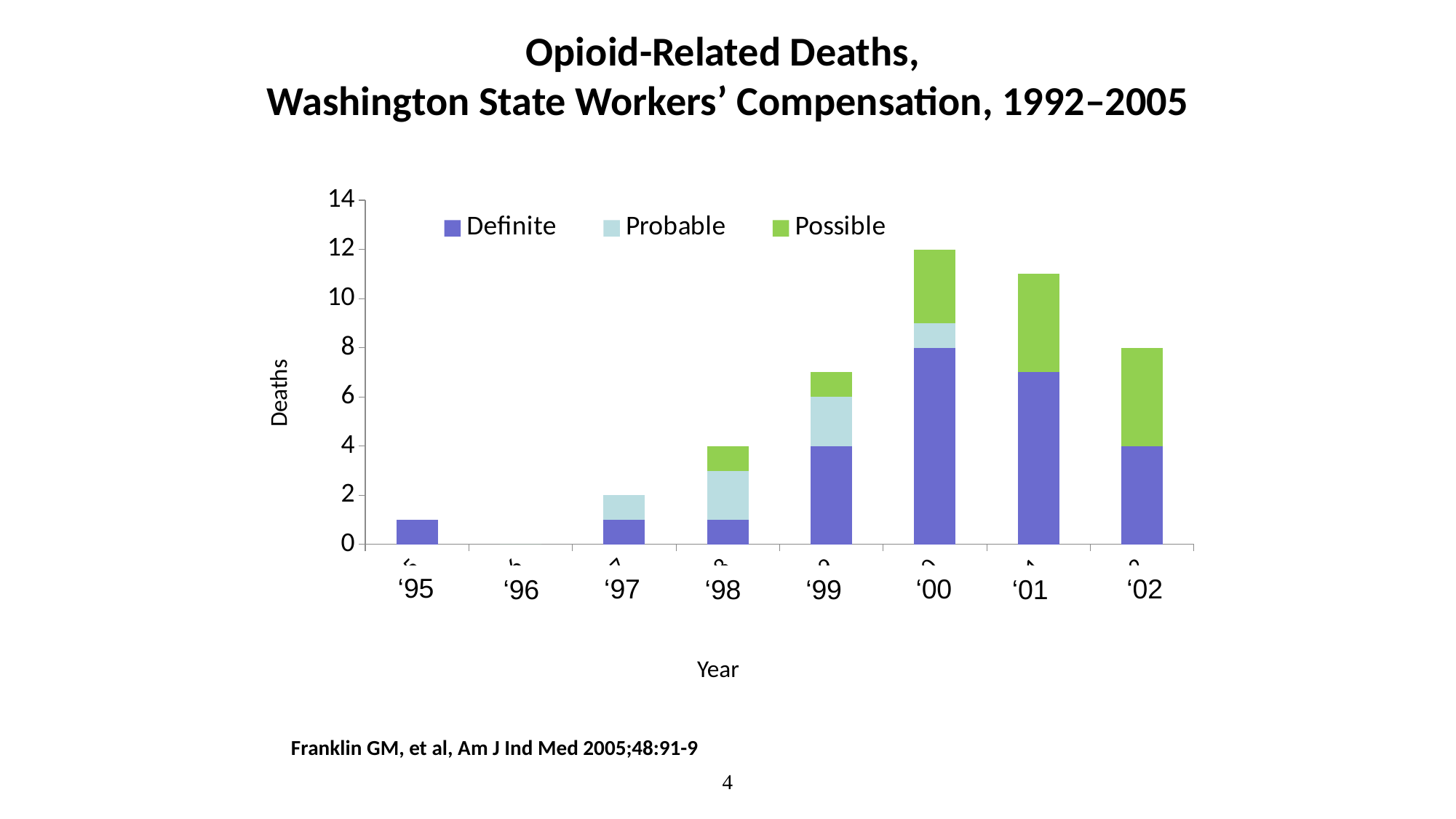
Which year shows no deaths at all? '96 What is the total number of deaths in '98? 4 What is the total number of deaths in '00? 12 Which year has the highest total number of deaths? '00 Is the total number of deaths in '01 greater or less than 10? greater What kind of chart is shown on the slide? Stacked bar chart How many years are shown on the x axis? 8 Is the total number of deaths in '99 greater or less than 6? greater What is the total number of deaths in '02? 8 Which year has more total deaths, '00 or '01? '00 How many series does the legend list? 3 Which colour represents the Possible series in the legend? Green